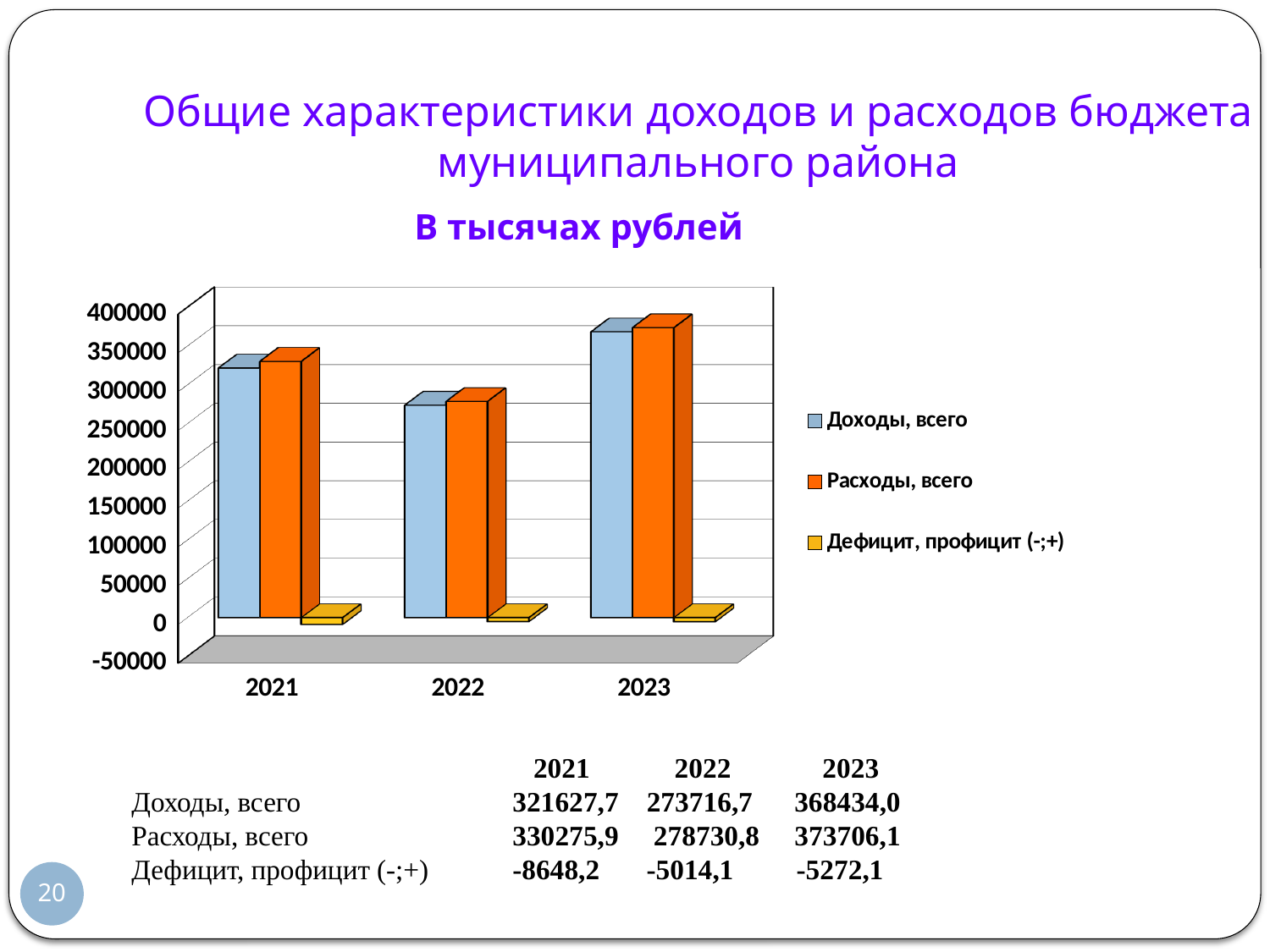
Does Расходы, всего rise or fall from 2022 to 2023? rise What is the value of Доходы, всего for 2021? 321627,7 Which is larger: Доходы, всего in 2022 or Доходы, всего in 2023? 2023 What is the value of Дефицит, профицит (-;+) for 2022? -5014,1 How many series does the legend list? 3 In which year is Доходы, всего the highest? 2023 Is the value of Доходы, всего for 2022 greater or less than 300000? less In which year is Расходы, всего the lowest? 2022 What kind of chart is shown on the slide? bar chart What is the value of Расходы, всего for 2023? 373706,1 How many years are shown on the x axis of the chart? 3 What is the difference between Расходы, всего and Доходы, всего in 2021? 8648,2